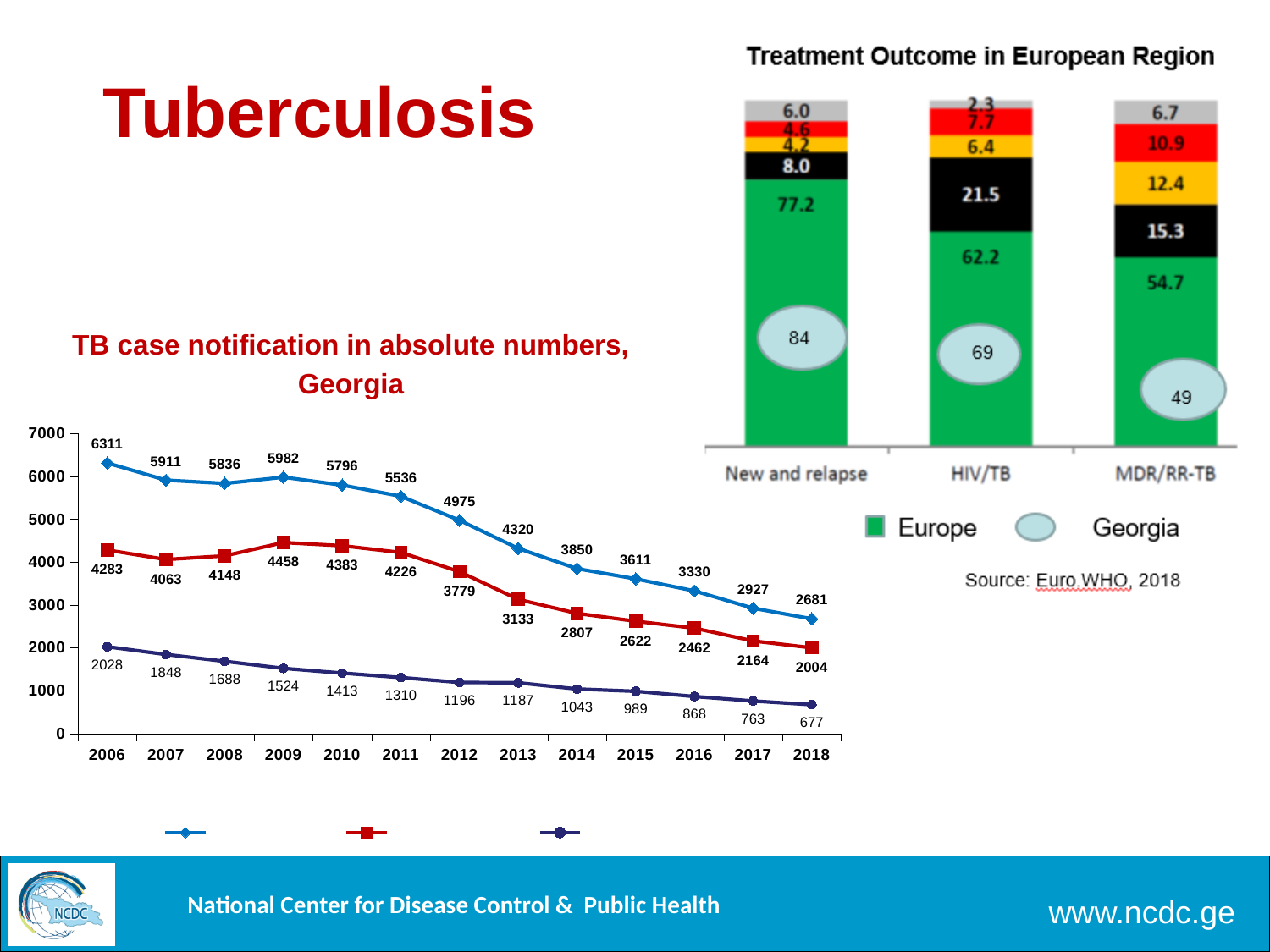
In the 'Treatment Outcome in European Region' chart, what is the value of the green Europe segment for MDR/RR-TB? 54.7 In the 'TB case notification in absolute numbers, Georgia' chart, in which year is the dark blue line at its lowest? 2018 In the 'TB case notification in absolute numbers, Georgia' chart, what is the value of the red line in 2018? 2004 In the 'Treatment Outcome in European Region' chart, which category has the largest green Europe segment? New and relapse What kind of chart is 'TB case notification in absolute numbers, Georgia'? Line chart In the 'TB case notification in absolute numbers, Georgia' chart, what is the value of the blue line in 2006? 6311 In the 'TB case notification in absolute numbers, Georgia' chart, what is the difference between the blue line's values in 2006 and 2018? 3630 In the 'Treatment Outcome in European Region' chart, what is the difference between the Georgia values for New and relapse and MDR/RR-TB? 35 In the 'TB case notification in absolute numbers, Georgia' chart, does the blue line rise or fall from 2006 to 2018? Fall In the 'TB case notification in absolute numbers, Georgia' chart, in which year does the red line reach its highest value? 2009 In the 'TB case notification in absolute numbers, Georgia' chart, how many years are shown on the x axis? 13 In the 'Treatment Outcome in European Region' chart, what is the Georgia value shown for HIV/TB? 69